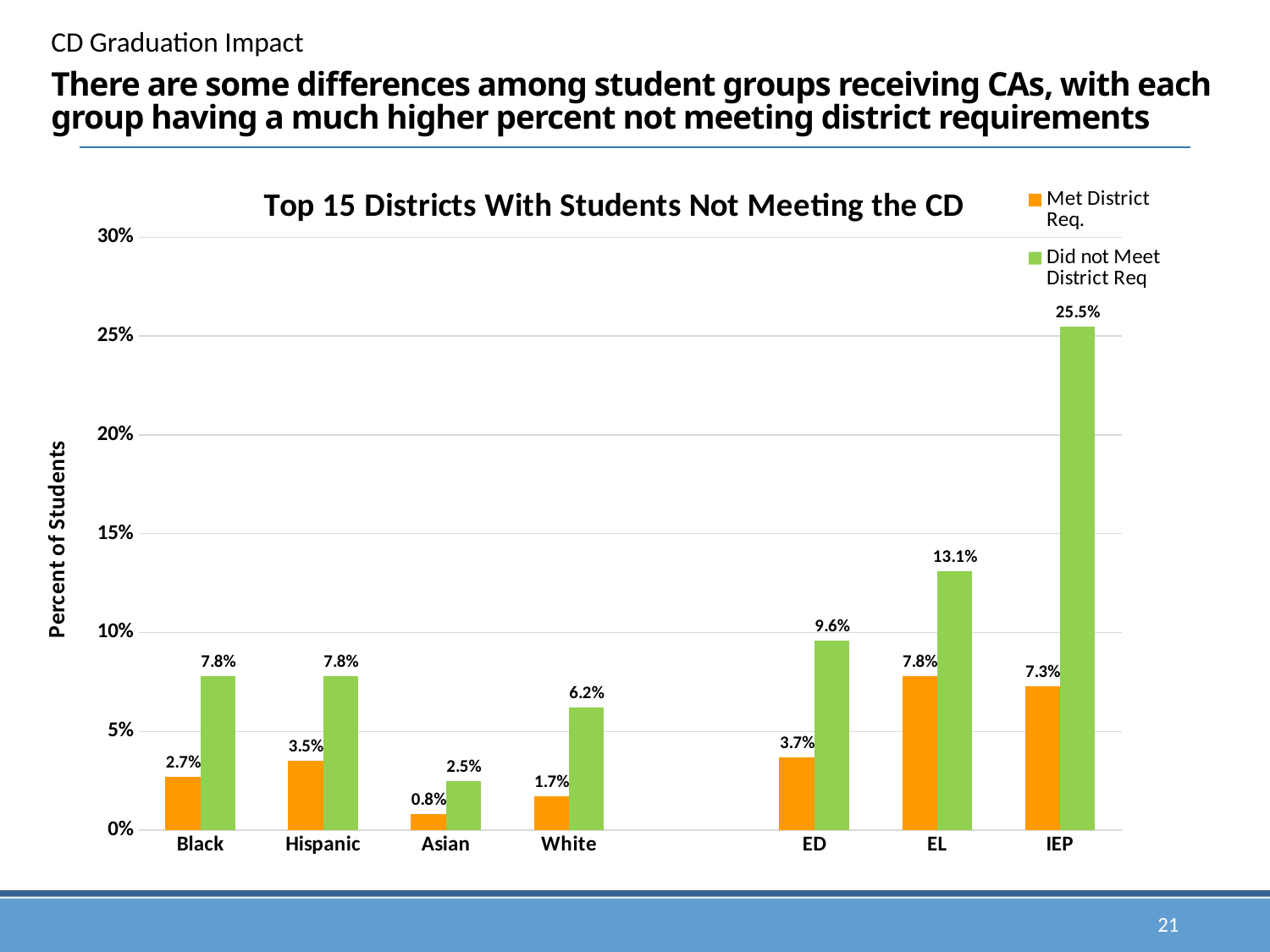
Which category has the lowest Met District Req. value? Asian What is the title of the chart? Top 15 Districts With Students Not Meeting the CD What is the value for Did not Meet District Req for IEP? 25.5% What kind of chart is shown? Bar chart What is the value for Did not Meet District Req for ED? 9.6% How many series does the legend list? 2 Which category has the highest Did not Meet District Req value? IEP What is the difference between the Did not Meet District Req and Met District Req. values for EL? 5.3% What is the label of the y axis? Percent of Students Which is larger: the Did not Meet District Req value for White or for Hispanic? Hispanic What is the value for Met District Req. for Asian? 0.8% How many categories are shown on the x axis? 7